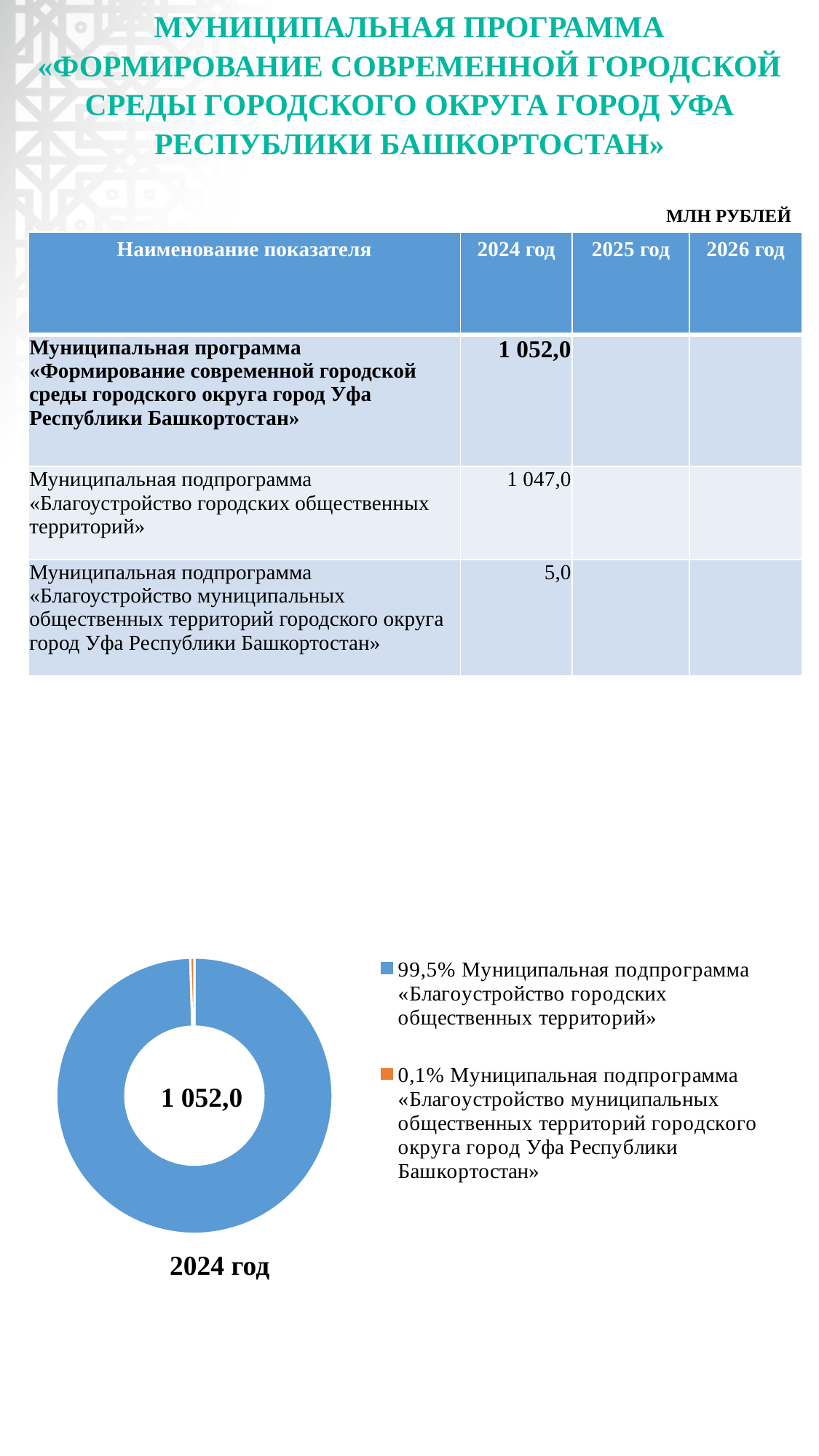
In the doughnut chart, which is larger: the share of «Благоустройство городских общественных территорий» or the share of «Благоустройство муниципальных общественных территорий городского округа город Уфа Республики Башкортостан»? «Благоустройство городских общественных территорий» How many entries does the legend of the doughnut chart list? 2 Which slice of the doughnut chart is the largest? Муниципальная подпрограмма «Благоустройство городских общественных территорий» What value is printed in the centre of the doughnut chart? 1 052,0 How many slices does the doughnut chart have? 2 What colour is the largest slice of the doughnut chart? blue Which slice of the doughnut chart is the smallest? Муниципальная подпрограмма «Благоустройство муниципальных общественных территорий городского округа город Уфа Республики Башкортостан» What kind of chart is shown at the bottom of the slide? doughnut chart What share of the doughnut chart does the subprogram «Благоустройство муниципальных общественных территорий городского округа город Уфа Республики Башкортостан» take? 0,1% What year label is shown below the doughnut chart? 2024 год What share of the doughnut chart does the subprogram «Благоустройство городских общественных территорий» take? 99,5%